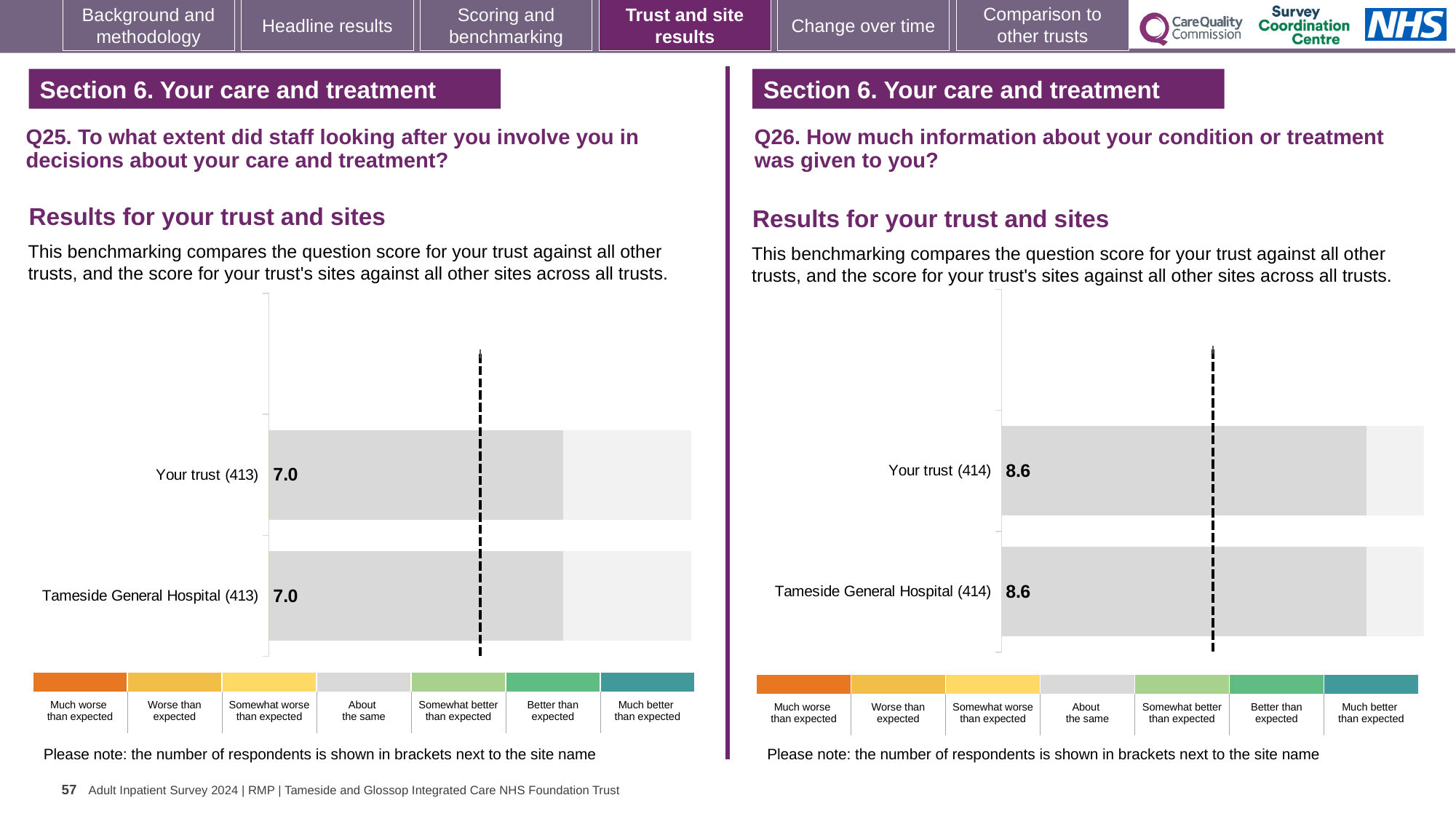
On the Q26 chart (right), how many respondents are shown in brackets next to Tameside General Hospital? 414 On the Q25 chart (left), how many bars are plotted? 2 On the Q26 chart (right), what is the score for Your trust? 8.6 On the Q25 chart (left), what is the score for Your trust? 7.0 On the Q25 chart (left), how many respondents are shown in brackets next to Your trust? 413 On the Q26 chart (right), what is the difference between the score for Your trust and the score for Tameside General Hospital? 0.0 Is the score for Your trust on the Q26 chart (right) larger or smaller than the score for Your trust on the Q25 chart (left)? Larger On the Q25 chart (left), what is the difference between the score for Your trust and the score for Tameside General Hospital? 0.0 On the Q26 chart (right), how many bars are plotted? 2 On the Q25 chart (left), what is the score for Tameside General Hospital? 7.0 What kind of chart is the Q25 chart (left)? Bar chart On the Q26 chart (right), what is the score for Tameside General Hospital? 8.6